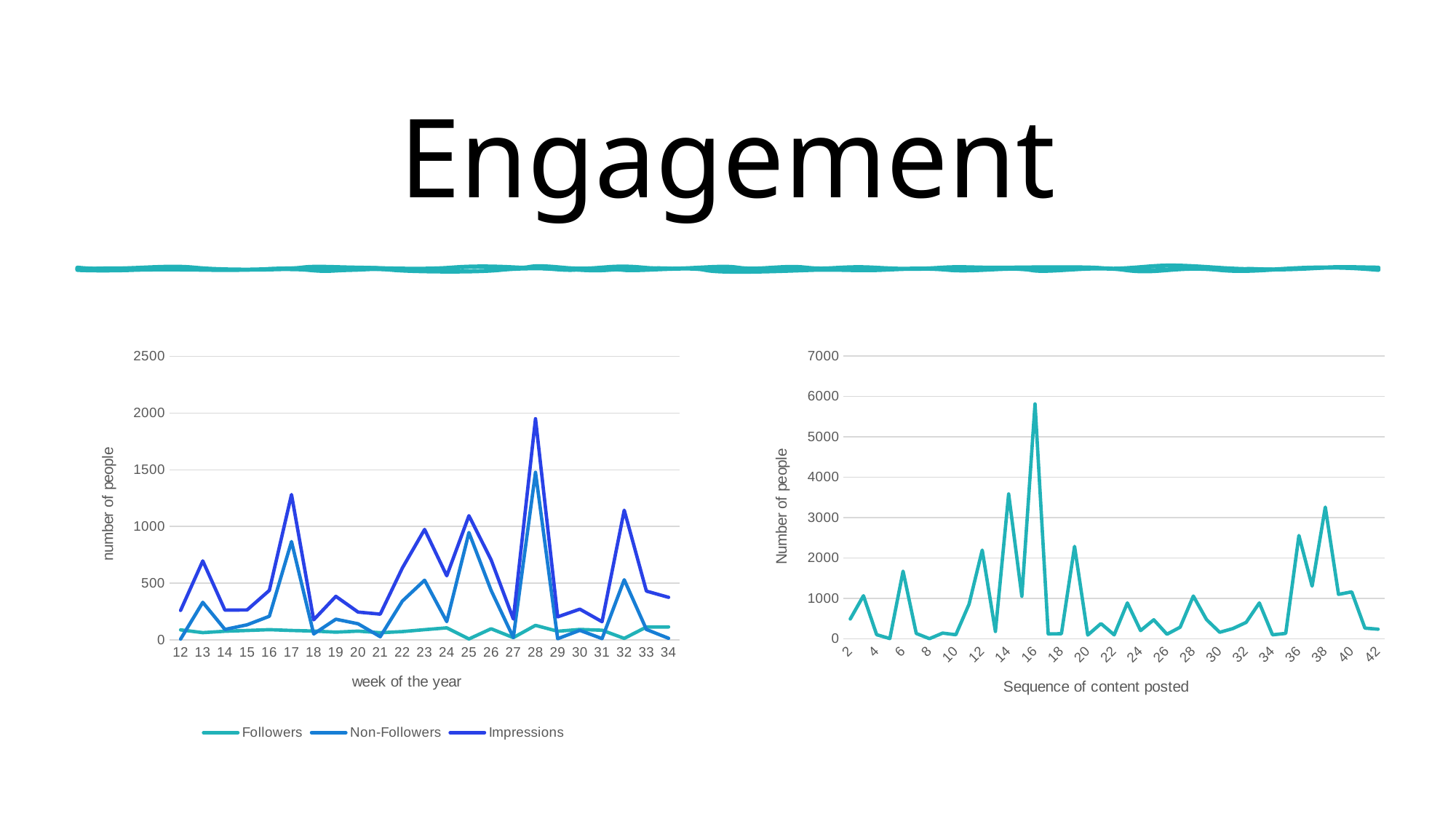
What kind of chart is the right chart on the slide? line chart In the left chart, is the Impressions value at week 28 greater or less than 1500? greater What is the x-axis label of the right chart? Sequence of content posted How many weeks are plotted along the x axis of the left chart? 23 In the right chart, is the value at sequence 38 greater or less than 3000? greater In the left chart, at which week of the year does the Impressions series reach its highest value? 28 How many series does the legend of the left chart list? 3 What is the x-axis label of the left chart? week of the year In the left chart, which series is higher at week 17, Impressions or Followers? Impressions In the left chart, is the Non-Followers value at week 17 greater or less than 500? greater What kind of chart is the left chart on the slide? line chart